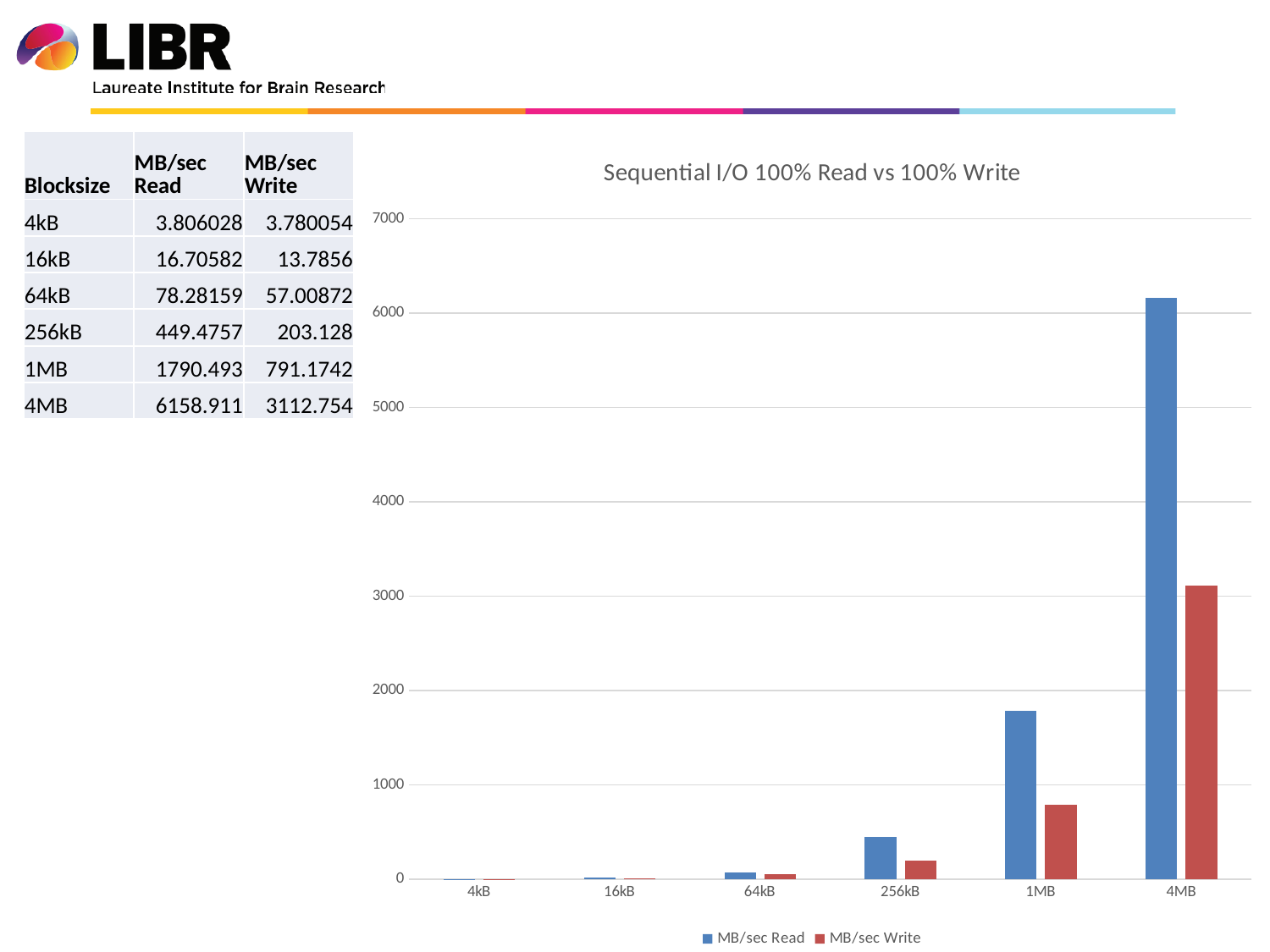
Do the MB/sec Read values rise or fall as blocksize increases along the x axis? rise What is the title of the chart? Sequential I/O 100% Read vs 100% Write What is the MB/sec Read value for the 4MB blocksize? 6158.911 What is the MB/sec Write value for the 1MB blocksize? 791.1742 What type of chart is shown on the slide? bar chart Which blocksize has the highest MB/sec Read value? 4MB What is the MB/sec Read value for the 256kB blocksize? 449.4757 Which is larger for the 1MB blocksize, MB/sec Read or MB/sec Write? MB/sec Read Is the MB/sec Read value for 4MB greater or less than 6000? greater How many blocksize categories are shown on the x axis of the chart? 6 How many series does the chart legend list? 2 Which blocksize has the lowest MB/sec Write value? 4kB